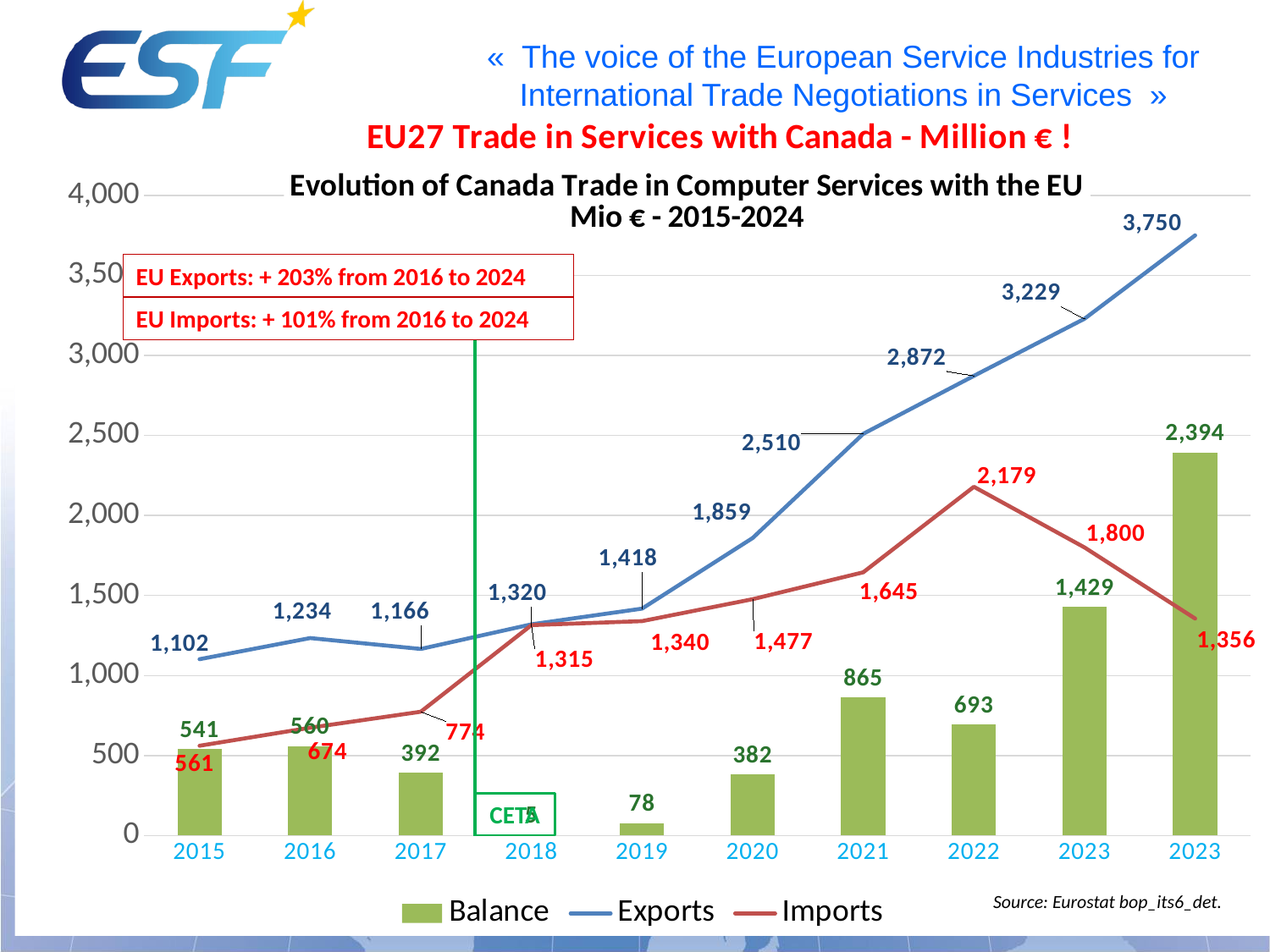
What is the difference between Exports and Imports in 2019? 78 In which year is the Imports value highest? 2022 In which year is the Balance bar lowest? 2018 How many series does the legend list? 3 What kind of chart is this? Combined bar and line chart What is the Balance value for 2021? 865 How many years are shown on the x axis? 10 What is the Imports value for 2022? 2,179 Which year has the larger Exports value, 2016 or 2017? 2016 By how much did Imports increase from 2021 to 2022? 534 Is the Imports value for 2021 greater or less than 1,500? greater What is the Exports value for 2020? 1,859